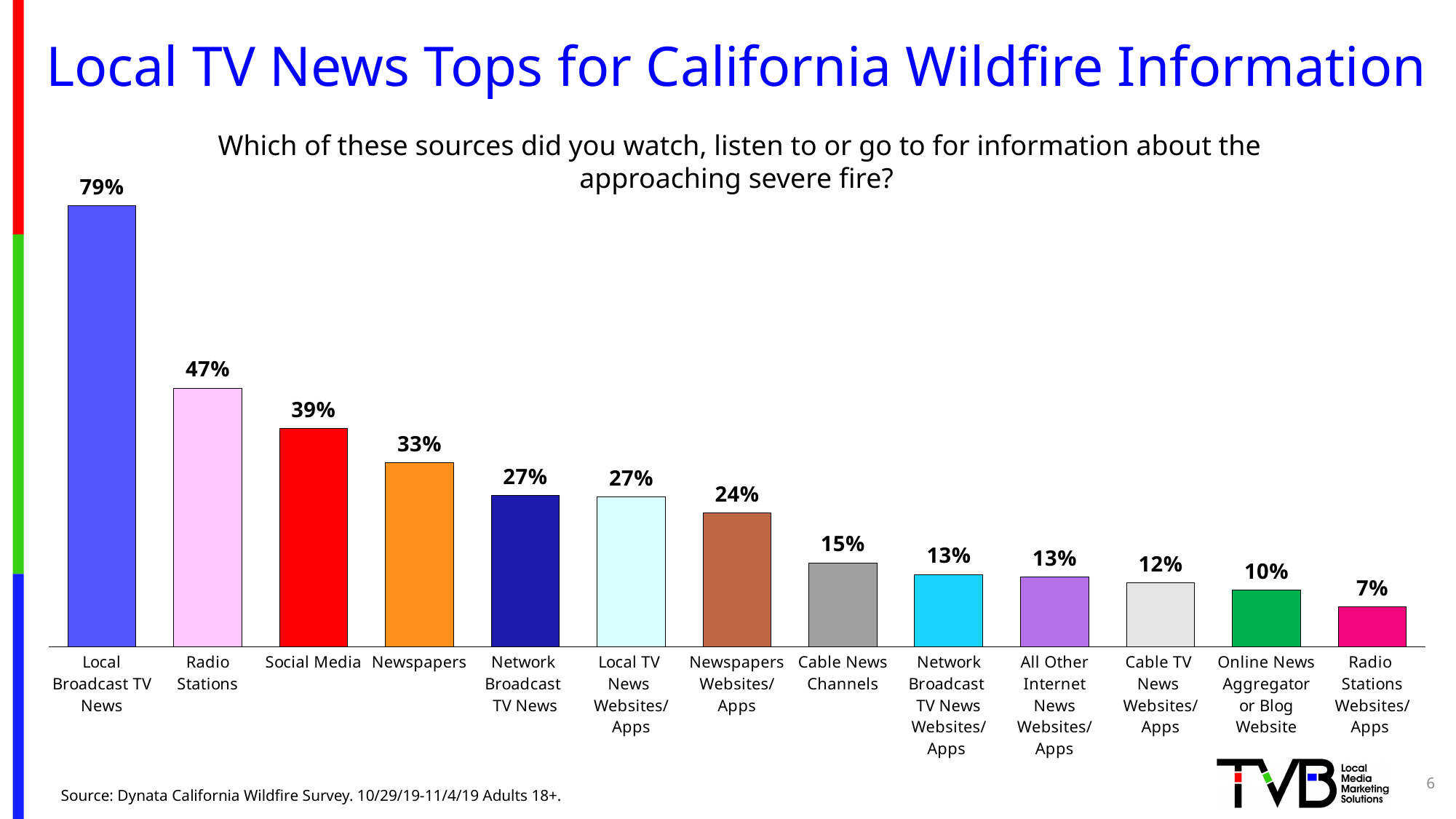
What is the difference between the values for Social Media and Newspapers? 6% How many sources are shown on the chart? 13 What is the title of the slide? Local TV News Tops for California Wildfire Information Which is larger, the value for Newspapers Websites/Apps or the value for Cable TV News Websites/Apps? Newspapers Websites/Apps What percentage is shown for Cable News Channels? 15% Which source has the lowest value on the chart? Radio Stations Websites/Apps What is the difference between the values for Local Broadcast TV News and Radio Stations? 32% Do the values rise or fall moving from left to right along the x axis? Fall What kind of chart is shown on the slide? Bar chart What is the value shown for Radio Stations? 47% Which source has the highest value on the chart? Local Broadcast TV News What percentage of respondents used Local Broadcast TV News for information about the approaching fire? 79%